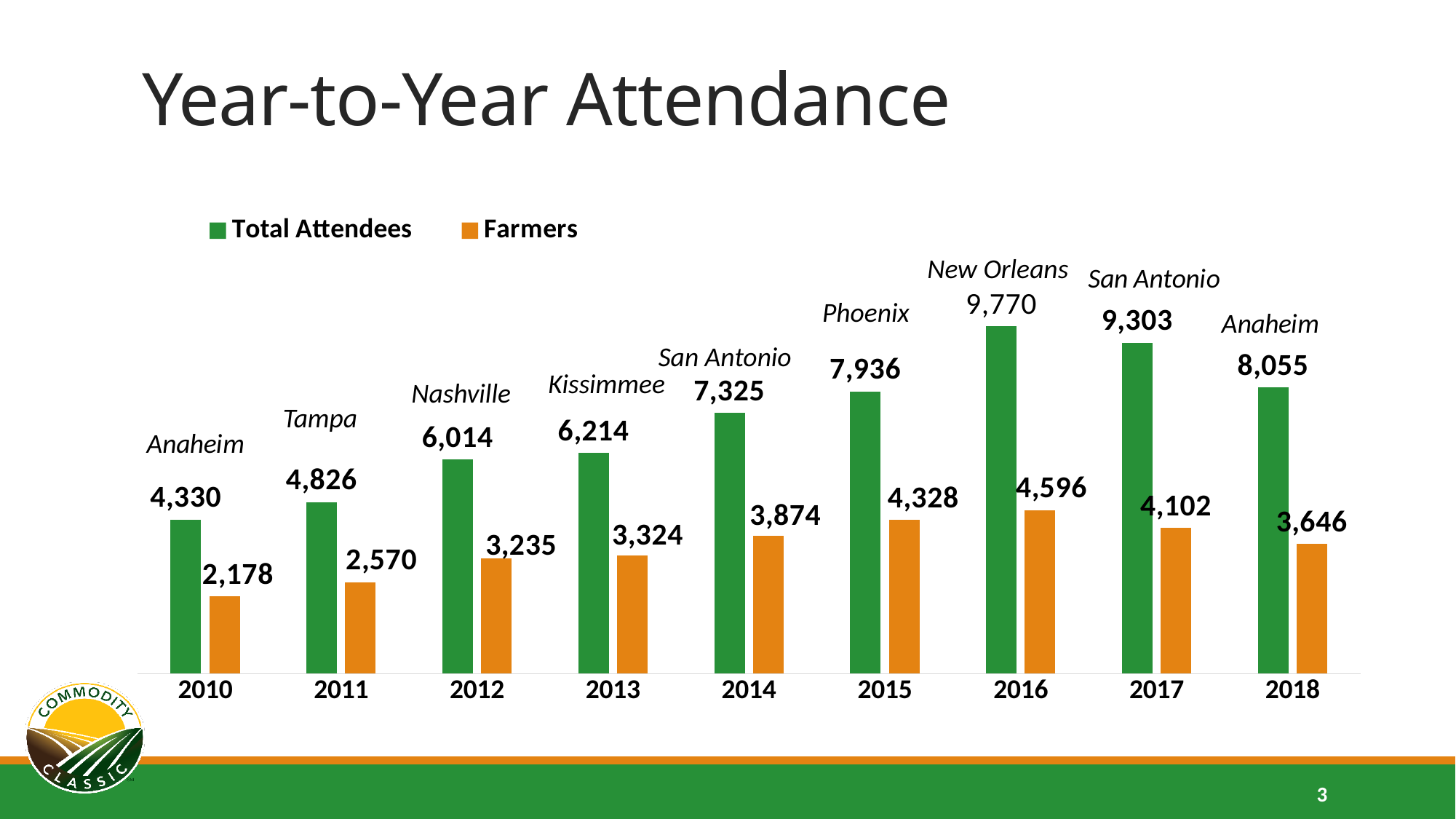
What is the difference between Total Attendees and Farmers in 2018? 4,409 Do Total Attendees rise or fall from 2010 to 2016? Rise Which year had the lowest number of Farmers? 2010 How many series does the legend list? 2 What colour represents the Farmers series? Orange How many Farmers attended in 2017? 4,102 Which city label is shown above the 2012 bars? Nashville Which year had the highest Total Attendees? 2016 What was the Total Attendees value in 2014? 7,325 Which is larger: Farmers in 2015 or Farmers in 2016? Farmers in 2016 How many years are shown on the x axis? 9 What kind of chart is shown on the slide? Bar chart